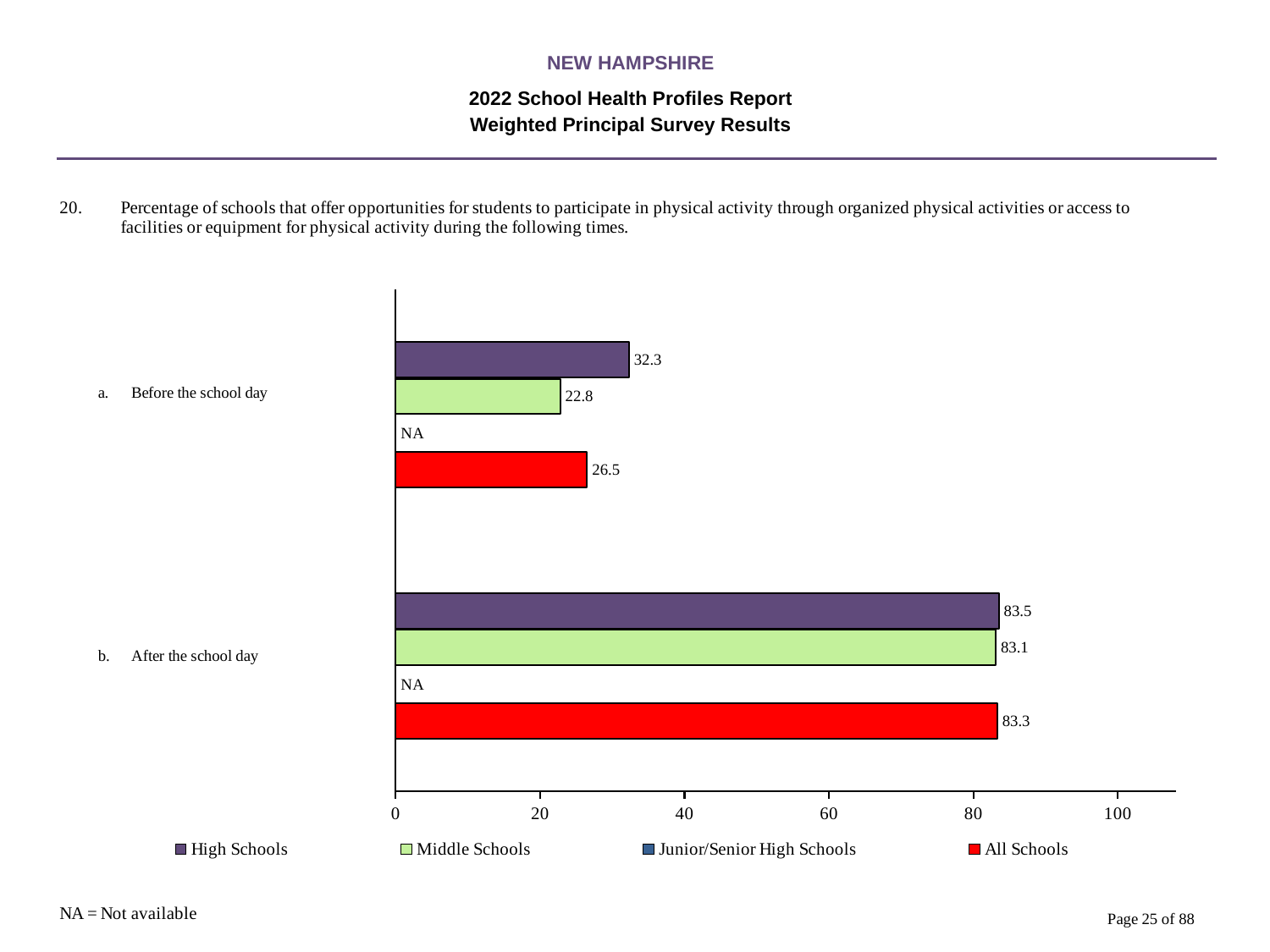
What colour are the All Schools bars? Red Is the value for High Schools for 'After the school day' greater or less than 80? greater What is the difference between the High Schools and Middle Schools values for 'Before the school day'? 9.5 Which series has the lowest value for 'Before the school day'? Middle Schools What is the value for All Schools for 'Before the school day'? 26.5 What is shown for Junior/Senior High Schools for 'After the school day'? NA What kind of chart is shown on the slide? Bar chart What is the value for High Schools for 'Before the school day'? 32.3 What is the value for Middle Schools for 'After the school day'? 83.1 Which is larger for All Schools: 'Before the school day' or 'After the school day'? After the school day Which series has the highest value for 'Before the school day'? High Schools How many series does the legend list? 4